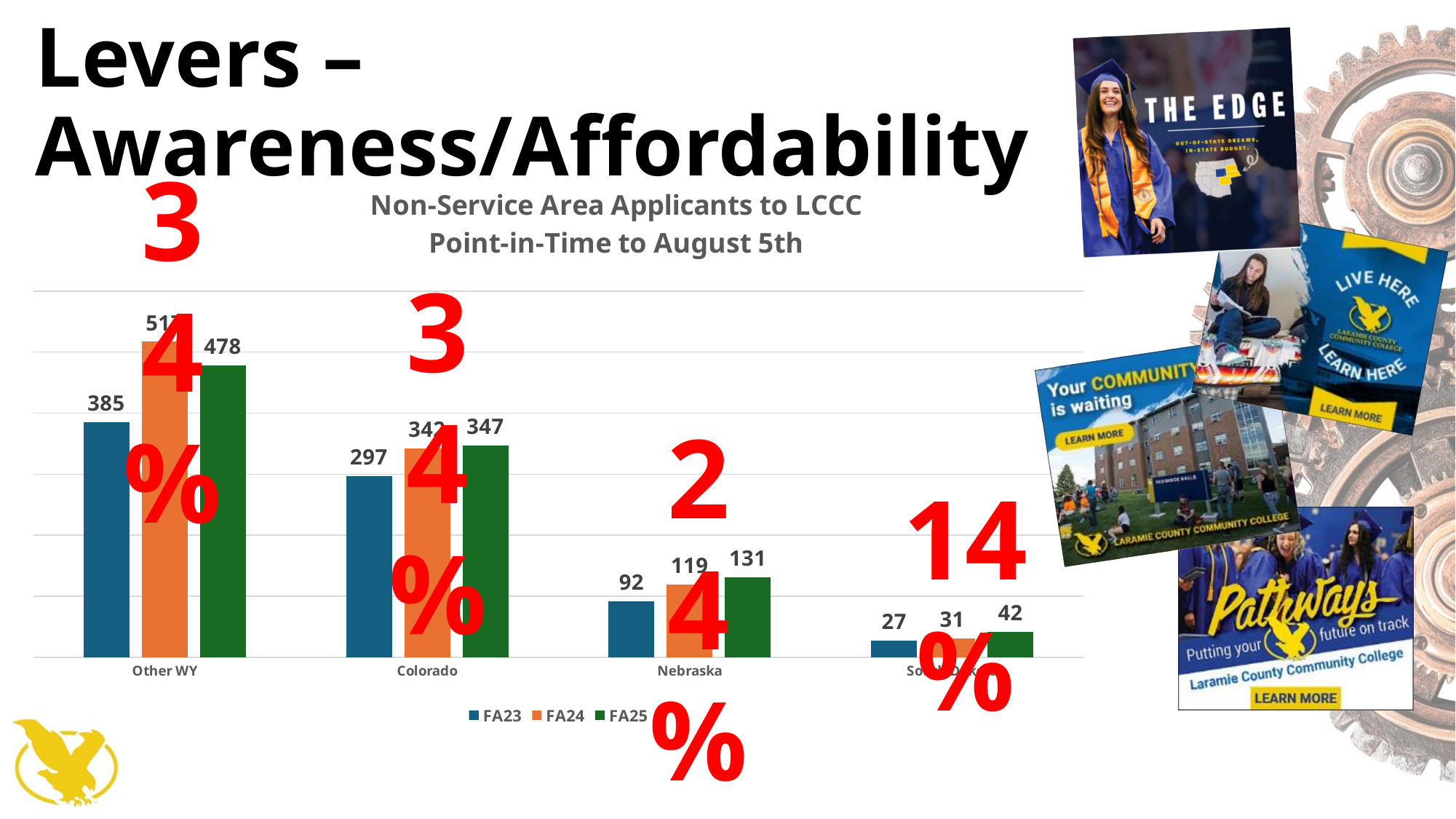
Which category has the highest FA25 value? Other WY Do the values for Nebraska rise or fall from FA23 to FA25? Rise Which is larger, the FA23 value for Colorado or the FA23 value for Nebraska? Colorado What is the difference between the FA25 and FA23 values for Nebraska? 39 How many series does the legend list? 3 What is the FA23 value for Colorado? 297 What is the FA25 value for Other WY? 478 What is the FA25 value for Colorado? 347 What kind of chart is shown on the slide? Bar chart What is the difference between the FA25 and FA23 values for Other WY? 93 What is the FA24 value for Nebraska? 119 What is the FA23 value for Other WY? 385